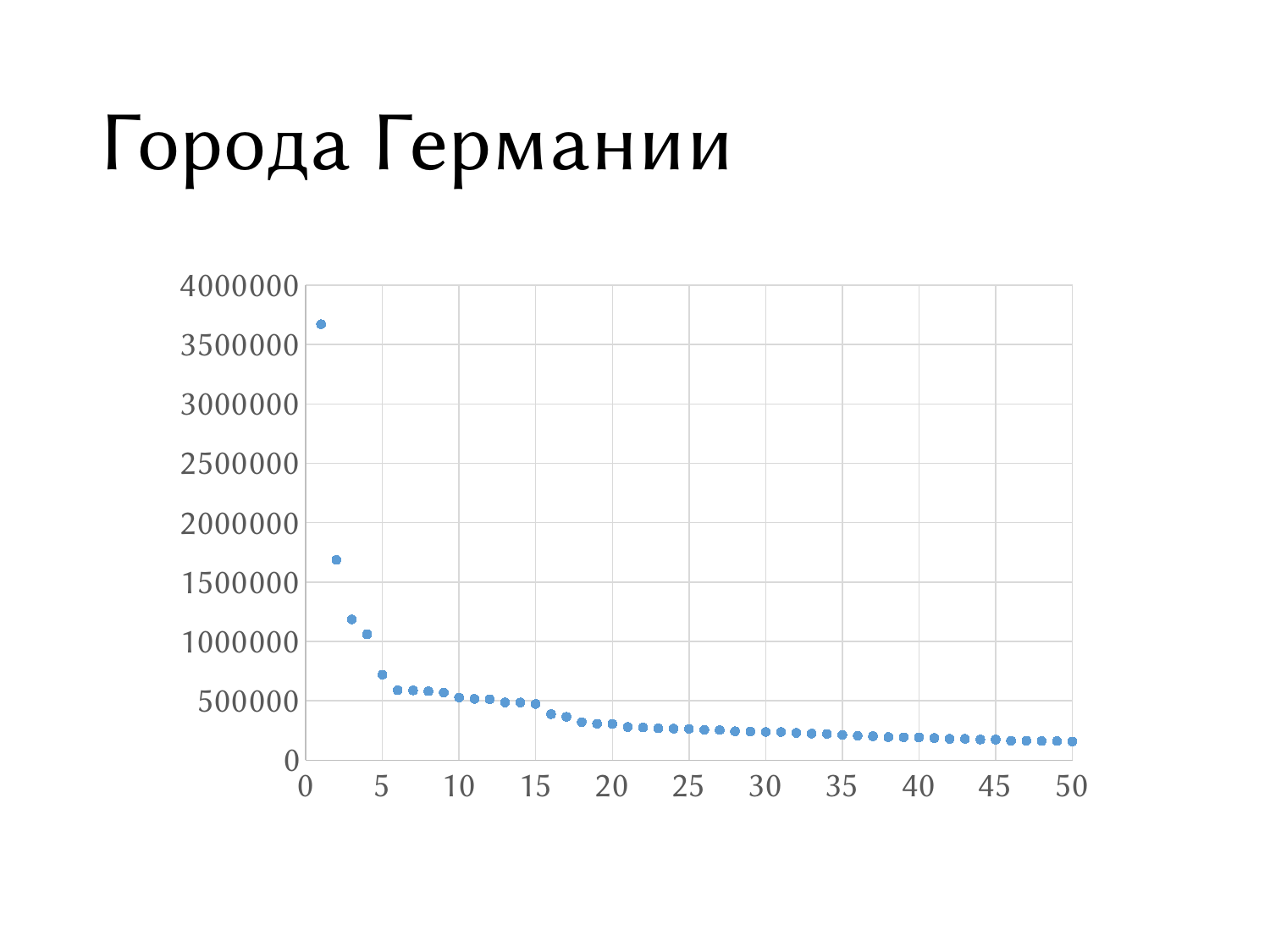
Which is larger, the value at x = 2 or the value at x = 5? x = 2 Is the value at x = 5 greater or less than 1000000? less What kind of chart is shown on the slide? scatter chart Do the plotted values rise or fall as x increases from 1 to 50? fall Is the value at x = 50 greater or less than 500000? less At which x value is the highest point plotted? 1 Is the value at x = 2 greater or less than 1500000? greater What is the title of the chart? Города Германии What is the highest tick label shown on the vertical axis? 4000000